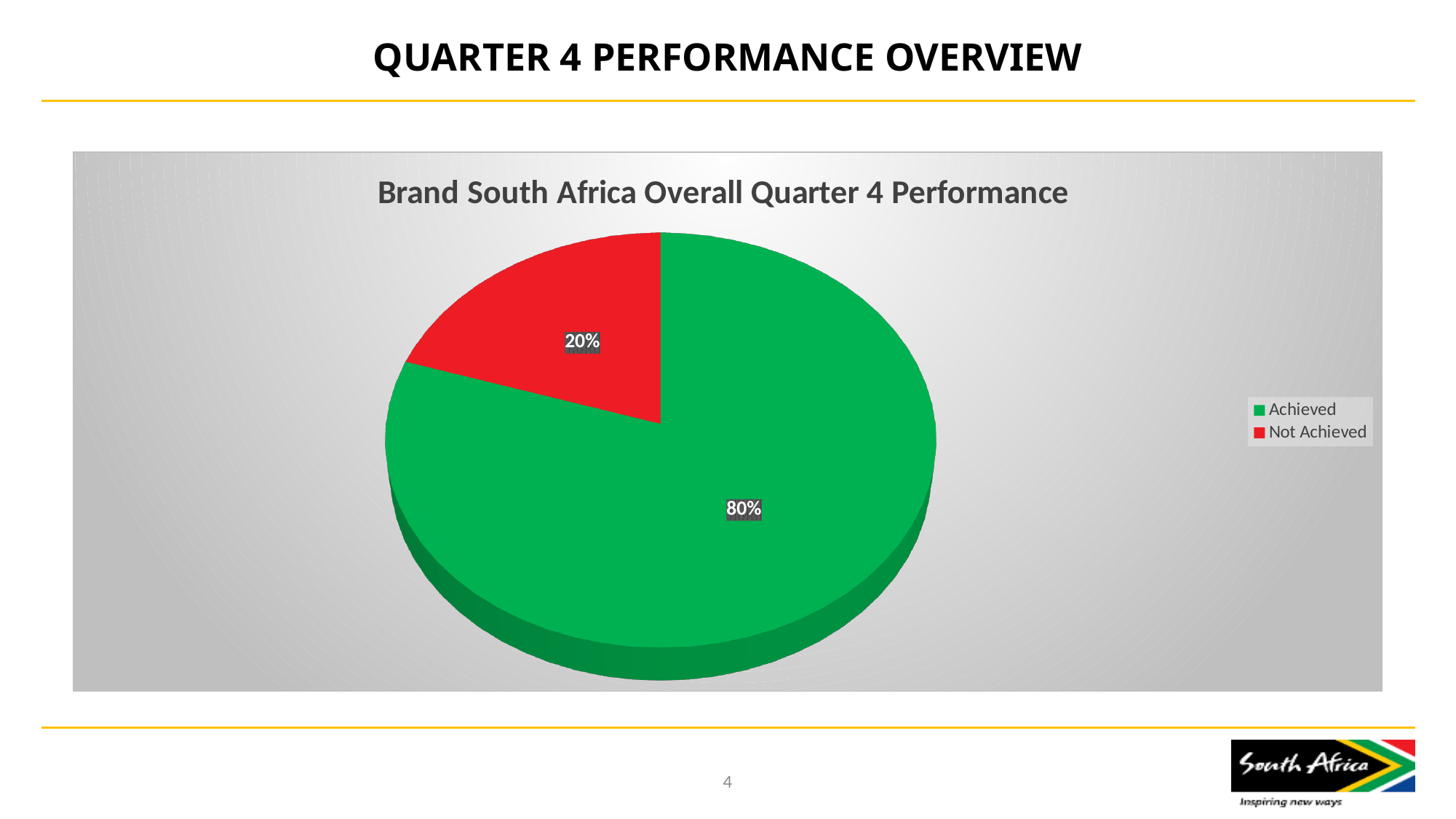
What share of the pie is labelled Not Achieved? 20% How many entries does the legend list? 2 What share of the pie is labelled Achieved? 80% What kind of chart is shown on the slide? Pie chart What is the title of the chart? Brand South Africa Overall Quarter 4 Performance How many slices does the pie chart have? 2 Which category has the largest slice of the pie? Achieved What colour is the Not Achieved slice? Red Which slice is larger, Achieved or Not Achieved? Achieved What is the difference in percentage points between the Achieved and Not Achieved slices? 60 Which category has the smallest slice of the pie? Not Achieved